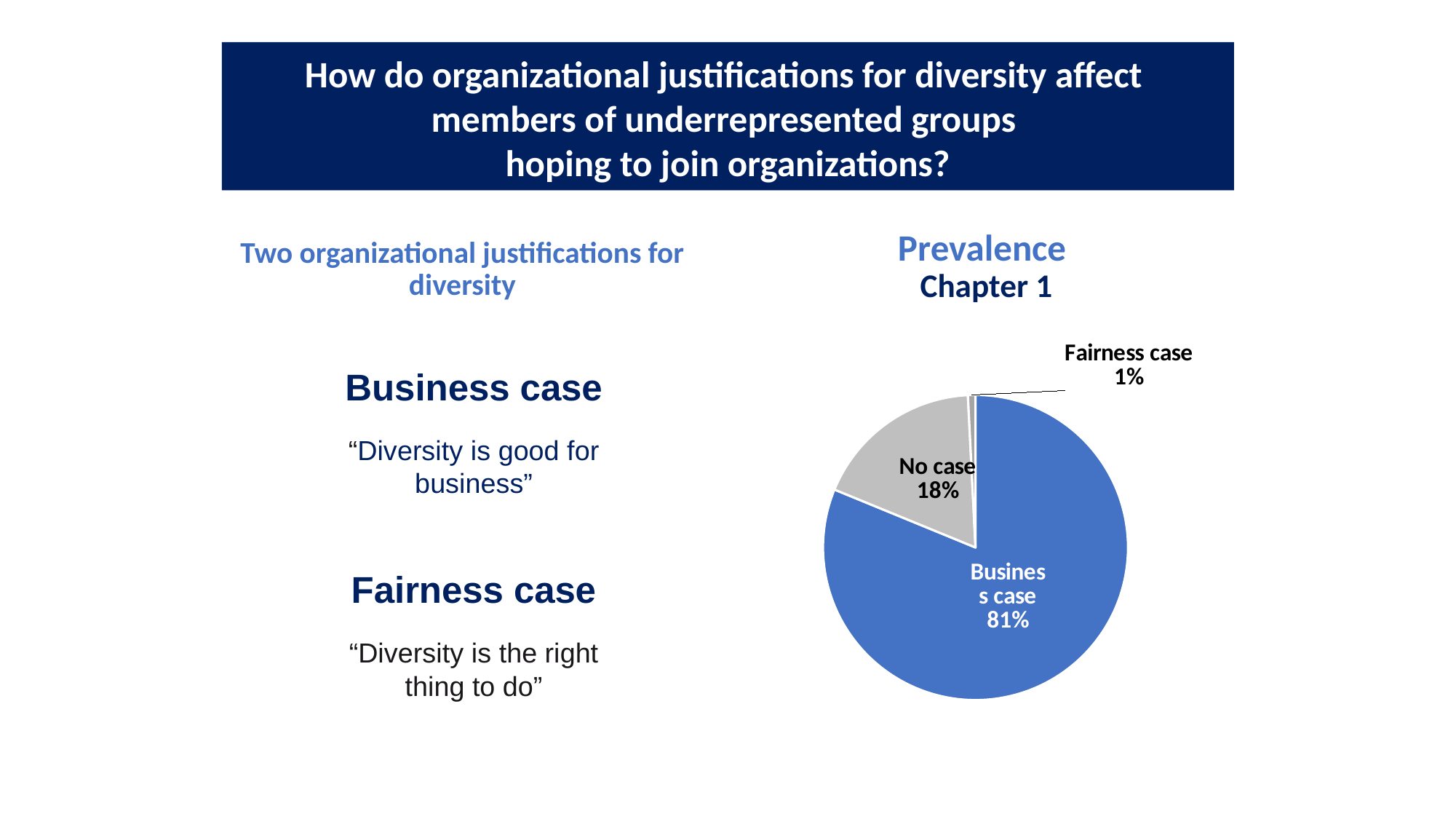
What share of the pie does the Fairness case slice represent? 1% Which slice of the pie chart is the smallest? Fairness case Which is larger, the No case slice or the Fairness case slice? No case Which slice of the pie chart is the largest? Business case What is the difference in percentage points between the Business case and No case slices? 63 What share of the pie does the Business case slice represent? 81% What is the title shown above the pie chart? Prevalence Chapter 1 How many slices does the pie chart have? 3 What colour is the Business case slice of the pie chart? blue What share of the pie does the No case slice represent? 18% What kind of chart is shown on the slide? pie chart What is the difference in percentage points between the No case and Fairness case slices? 17